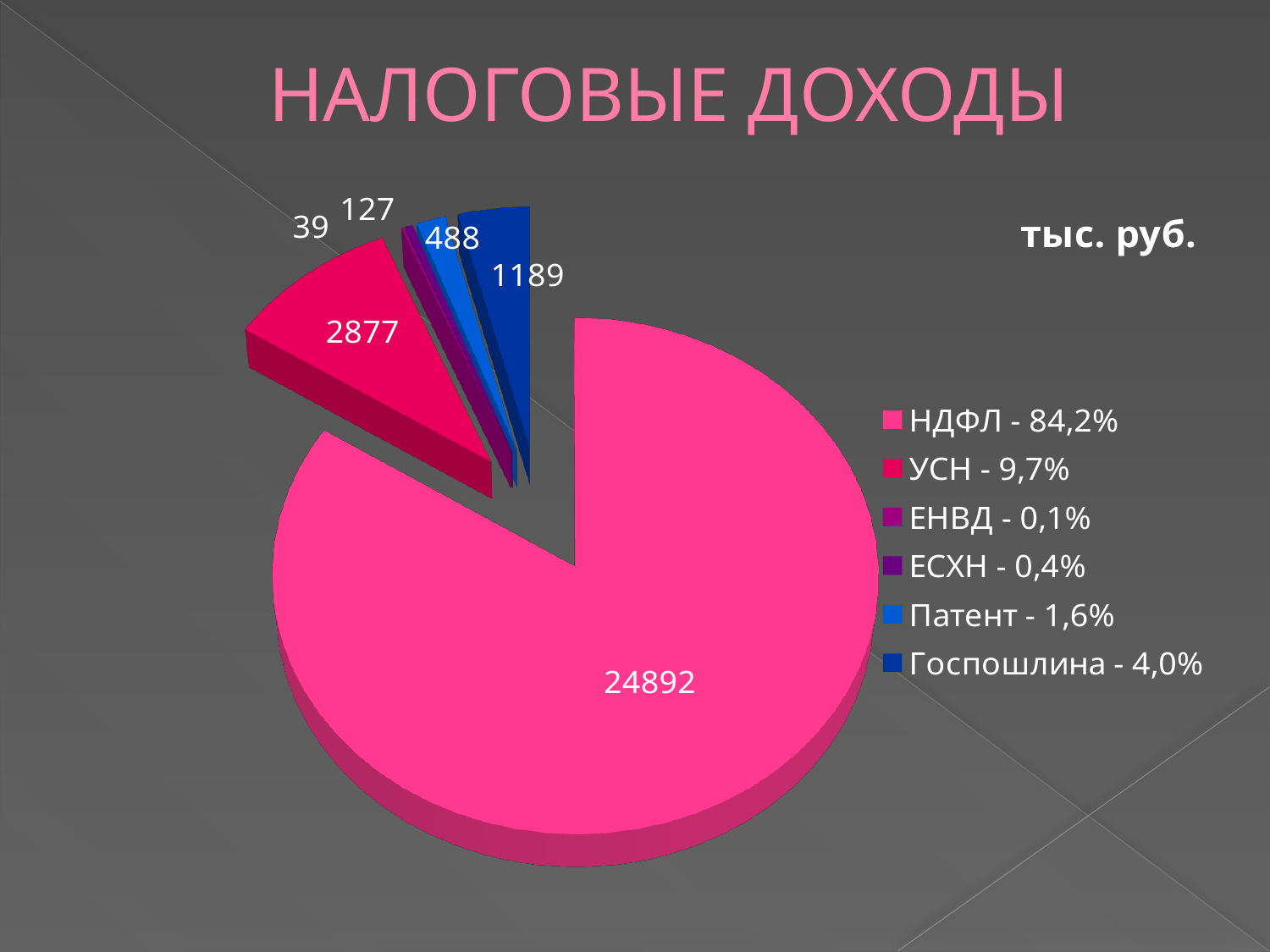
What share of the pie does УСН represent? 9,7% What is the difference between the values for УСН and Госпошлина? 1688 What kind of chart is shown on the slide? pie chart Which category has the smallest slice? ЕНВД What unit is indicated for the chart values? тыс. руб. Which is larger, the value for Патент or the value for ЕСХН? Патент What is the value for Патент? 488 What is the value for НДФЛ? 24892 What is the value for УСН? 2877 Which category has the largest slice? НДФЛ How many categories does the pie chart have? 6 What is the value for Госпошлина? 1189